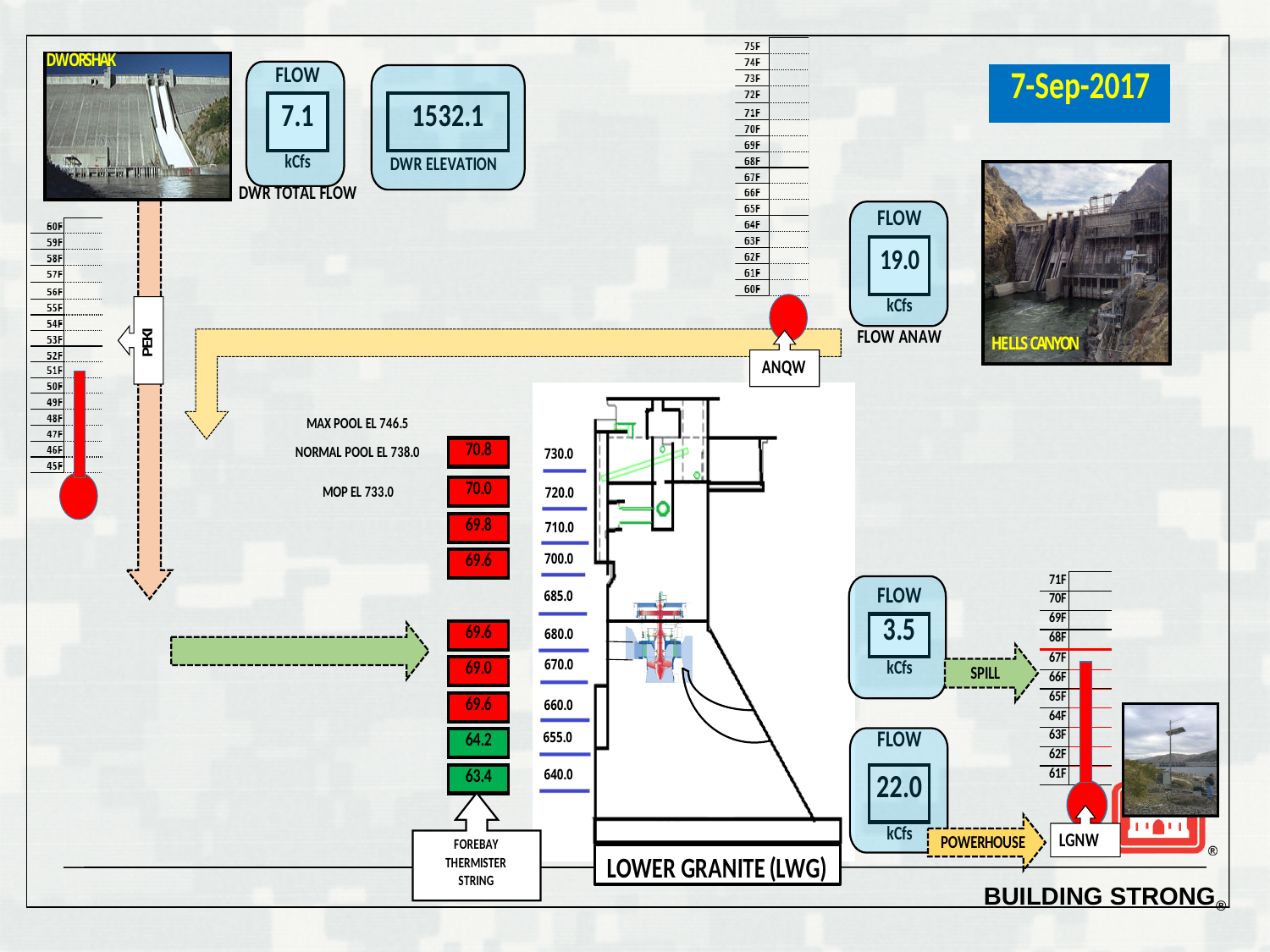
Which is larger at Lower Granite, the spill flow or the powerhouse flow? Powerhouse flow In the forebay thermister string, what is the highest temperature value shown? 70.8 What is the DWR elevation shown on the slide? 1532.1 What is the powerhouse flow at Lower Granite shown on the slide? 22.0 kCfs How many temperature readings are shown in the forebay thermister string? 9 What is the spill flow at Lower Granite shown on the slide? 3.5 kCfs What is the difference between the powerhouse flow and the spill flow at Lower Granite? 18.5 kCfs What is the flow at ANAW (ANQW) shown on the slide? 19.0 kCfs In the forebay thermister string, what is the lowest temperature value shown? 63.4 What date is shown on the slide? 7-Sep-2017 What is the difference between the flow at ANAW and the DWR total flow? 11.9 kCfs What is the DWR total flow shown on the slide? 7.1 kCfs